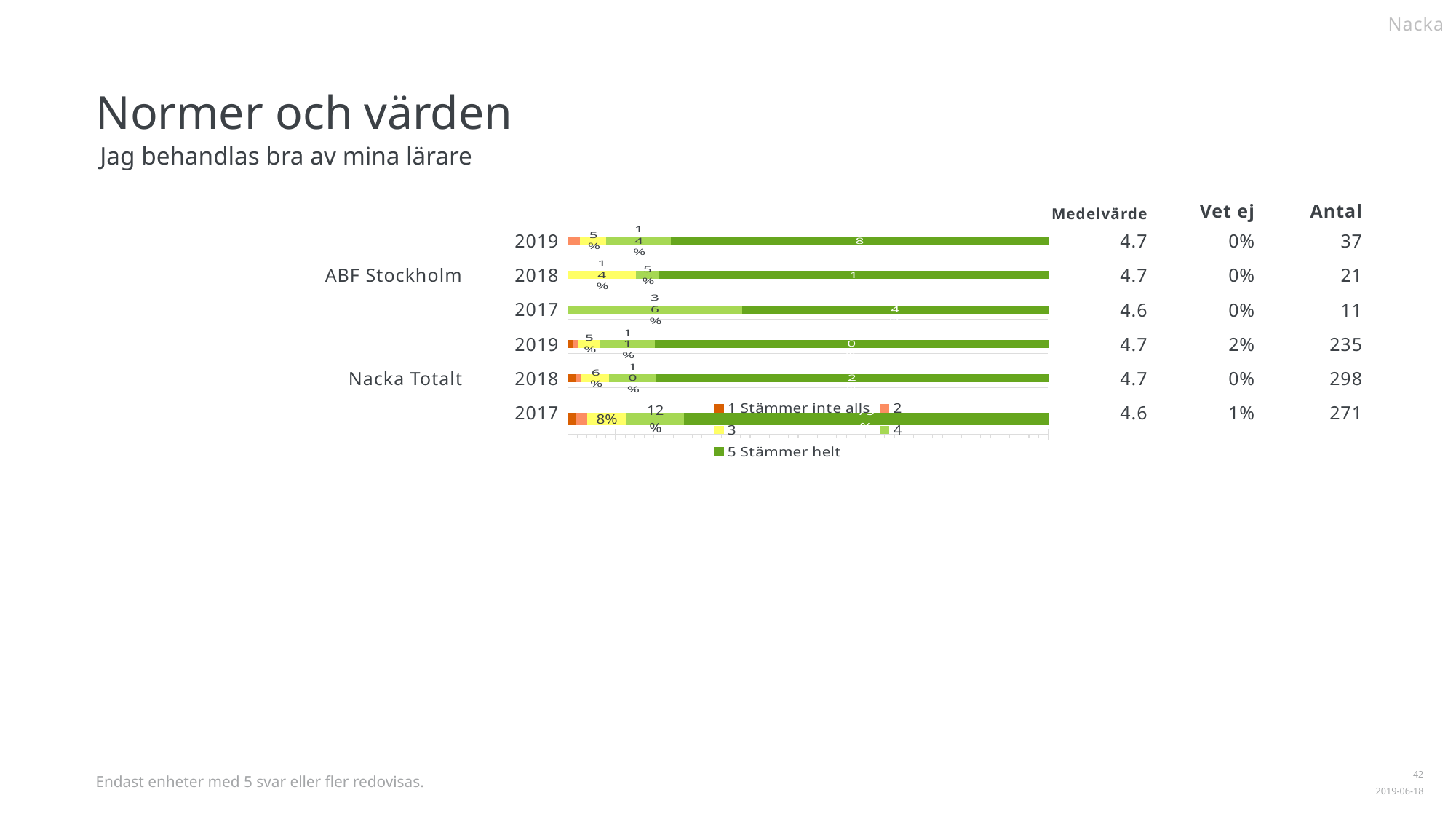
How many series does the chart legend list? 5 What is the difference between the '4' segment for ABF Stockholm 2019 (14%) and the '4' segment for Nacka Totalt 2019 (11%)? 3 percentage points What is the value of the '4' segment for Nacka Totalt in 2019? 11% How many bars are plotted in the chart? 6 What is the value of the '3' segment for Nacka Totalt in 2017? 8% What is the last entry in the chart legend? 5 Stämmer helt Which is larger: the '4' segment for ABF Stockholm 2017 or the '4' segment for Nacka Totalt 2017? ABF Stockholm 2017 What is the first entry in the chart legend? 1 Stämmer inte alls What is the value of the '4' segment for ABF Stockholm in 2017? 36% What is the value of the '3' segment for ABF Stockholm in 2018? 14% What is the value of the '4' segment for ABF Stockholm in 2019? 14% What kind of chart is shown on the slide? Stacked bar chart